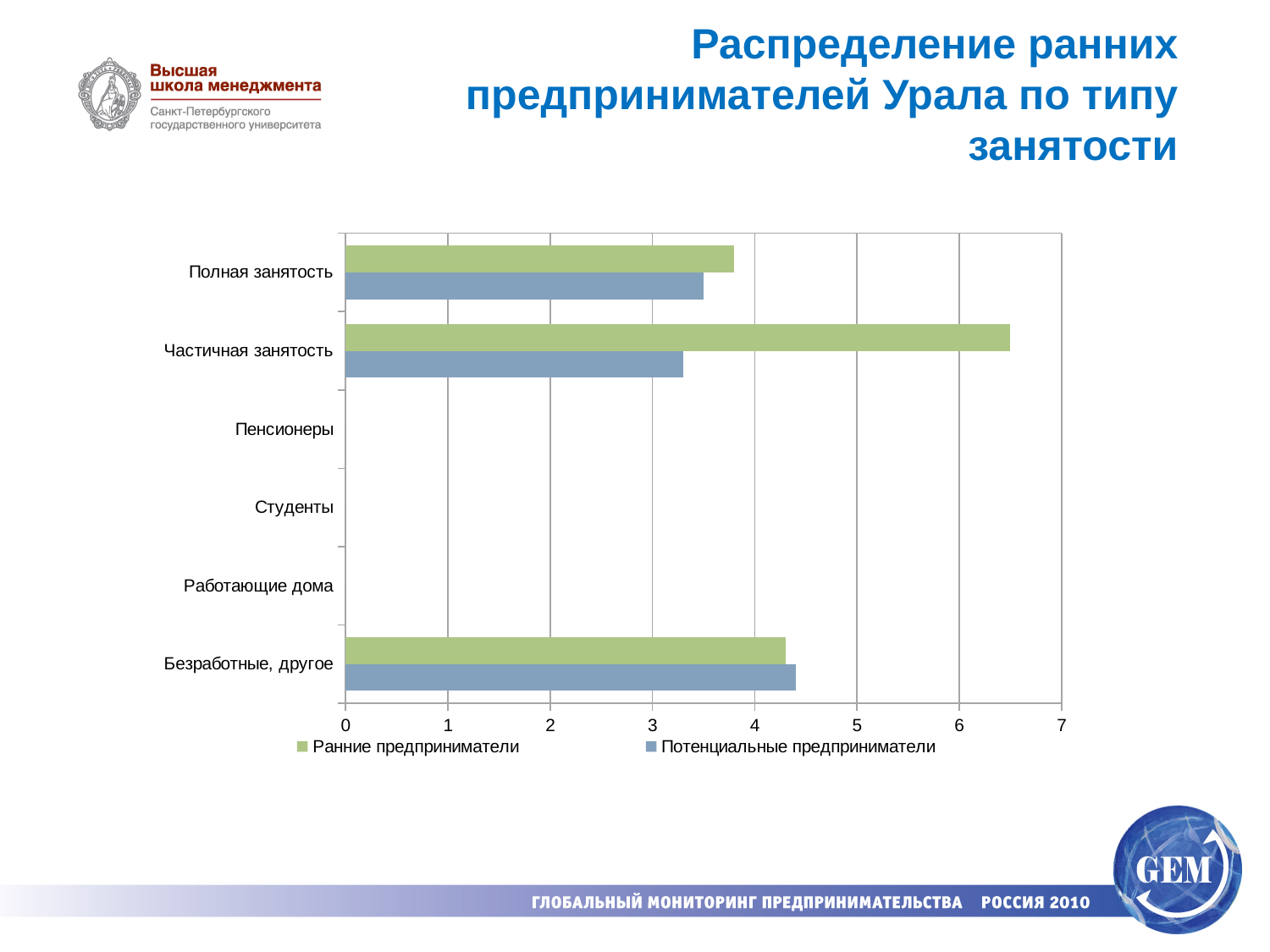
Which series is shown in green in the chart? Ранние предприниматели How many categories are shown on the vertical axis of the chart? 6 How many series does the legend list? 2 What is the maximum value shown on the horizontal axis of the chart? 7 Is the value for Потенциальные предприниматели in Частичная занятость greater or less than 4? less Which category has the highest value for Ранние предприниматели? Частичная занятость Is the value for Потенциальные предприниматели in Безработные, другое greater or less than 5? less Which category has the highest value for Потенциальные предприниматели? Безработные, другое Is the value for Ранние предприниматели in Полная занятость greater or less than 3? greater What kind of chart is shown on the slide? bar chart In Частичная занятость, which series has the larger value: Ранние предприниматели or Потенциальные предприниматели? Ранние предприниматели